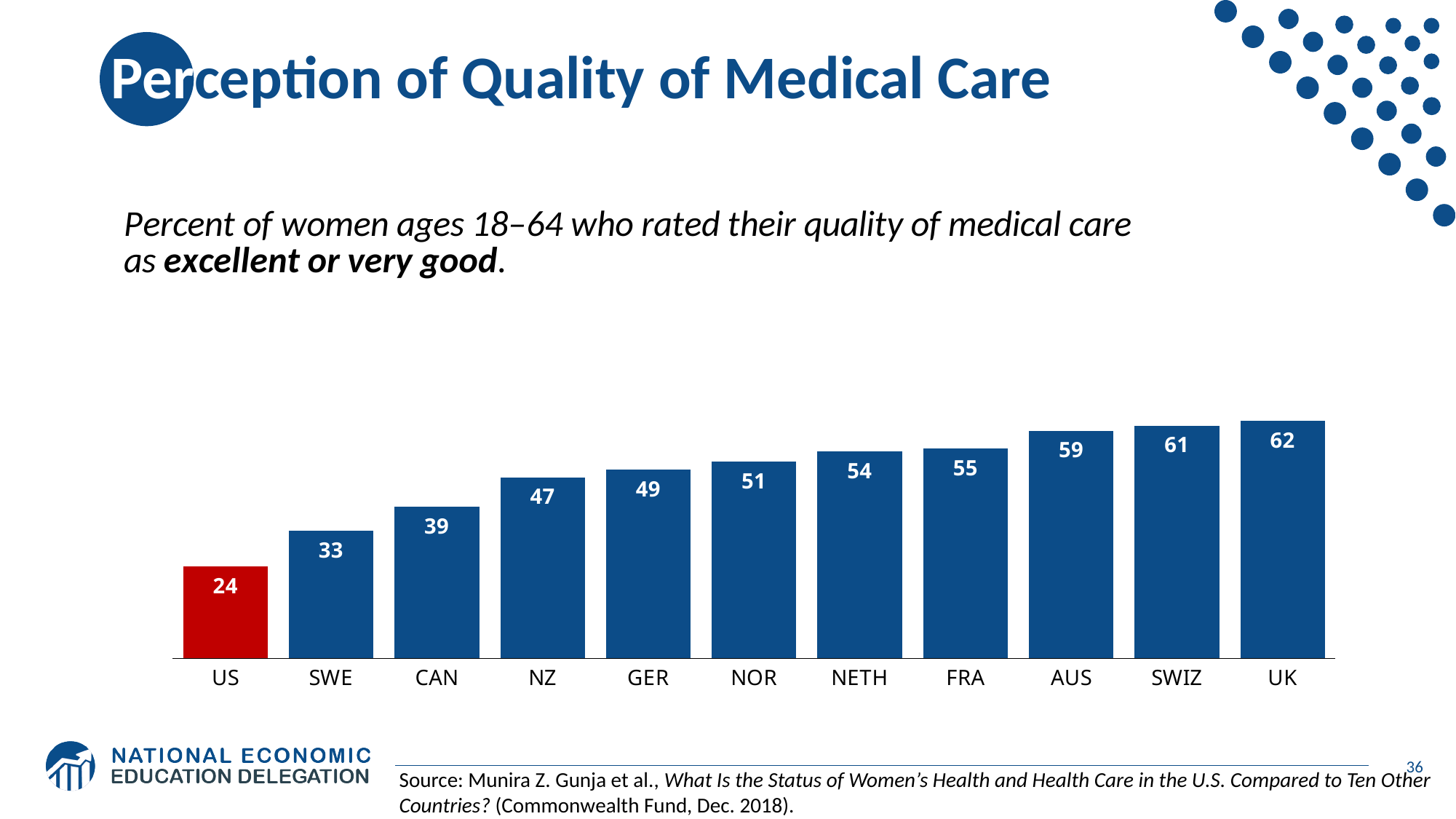
What is the difference between the values for UK and US? 38 Do the values rise or fall from left to right along the x axis? rise What is the value for the US? 24 What is the value for GER? 49 What is the difference between the values for CAN and SWE? 6 What is the value for AUS? 59 Which bar is coloured red rather than blue? US What kind of chart is shown on the slide? bar chart Which country has the highest value? UK How many countries are shown in the chart? 11 Which country has the lowest value? US Which is larger, the value for NOR or the value for NZ? NOR